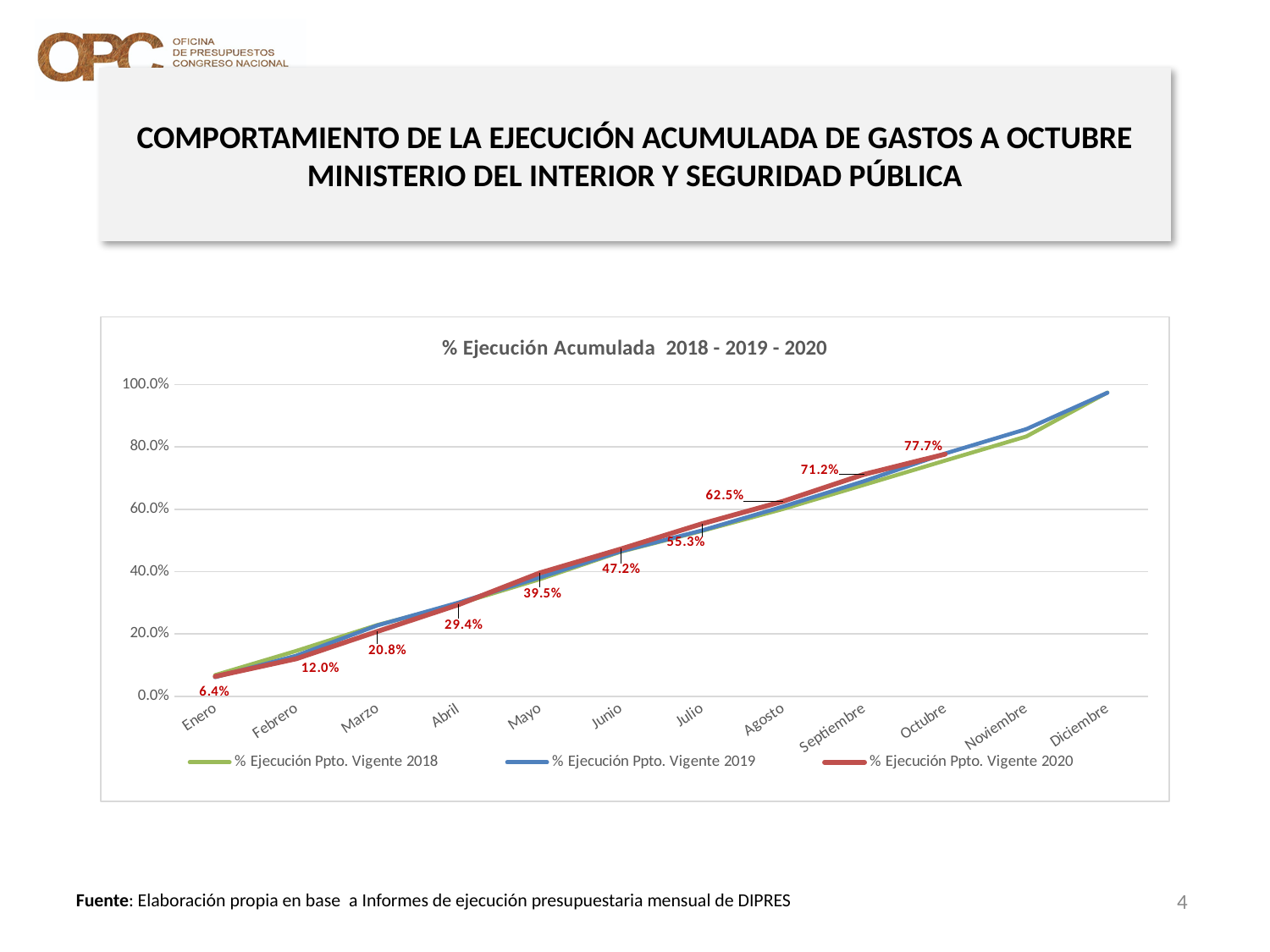
What is the value for % Ejecución Ppto. Vigente 2020 in Enero? 6.4% Is the value for % Ejecución Ppto. Vigente 2019 in Diciembre greater or less than 80.0%? greater What type of chart is shown on the slide? line chart What is the value for % Ejecución Ppto. Vigente 2020 in Octubre? 77.7% What is the value for % Ejecución Ppto. Vigente 2020 in Agosto? 62.5% What is the value for % Ejecución Ppto. Vigente 2020 in Mayo? 39.5% In which month is the % Ejecución Ppto. Vigente 2020 series highest? Octubre What is the difference between the 2020 values for Julio and Junio? 8.1% Do the values of the % Ejecución Ppto. Vigente 2020 series rise or fall from Enero to Octubre? rise How many months are shown along the x axis? 12 How many series does the legend list? 3 What is the difference between the 2020 values for Octubre and Septiembre? 6.5%